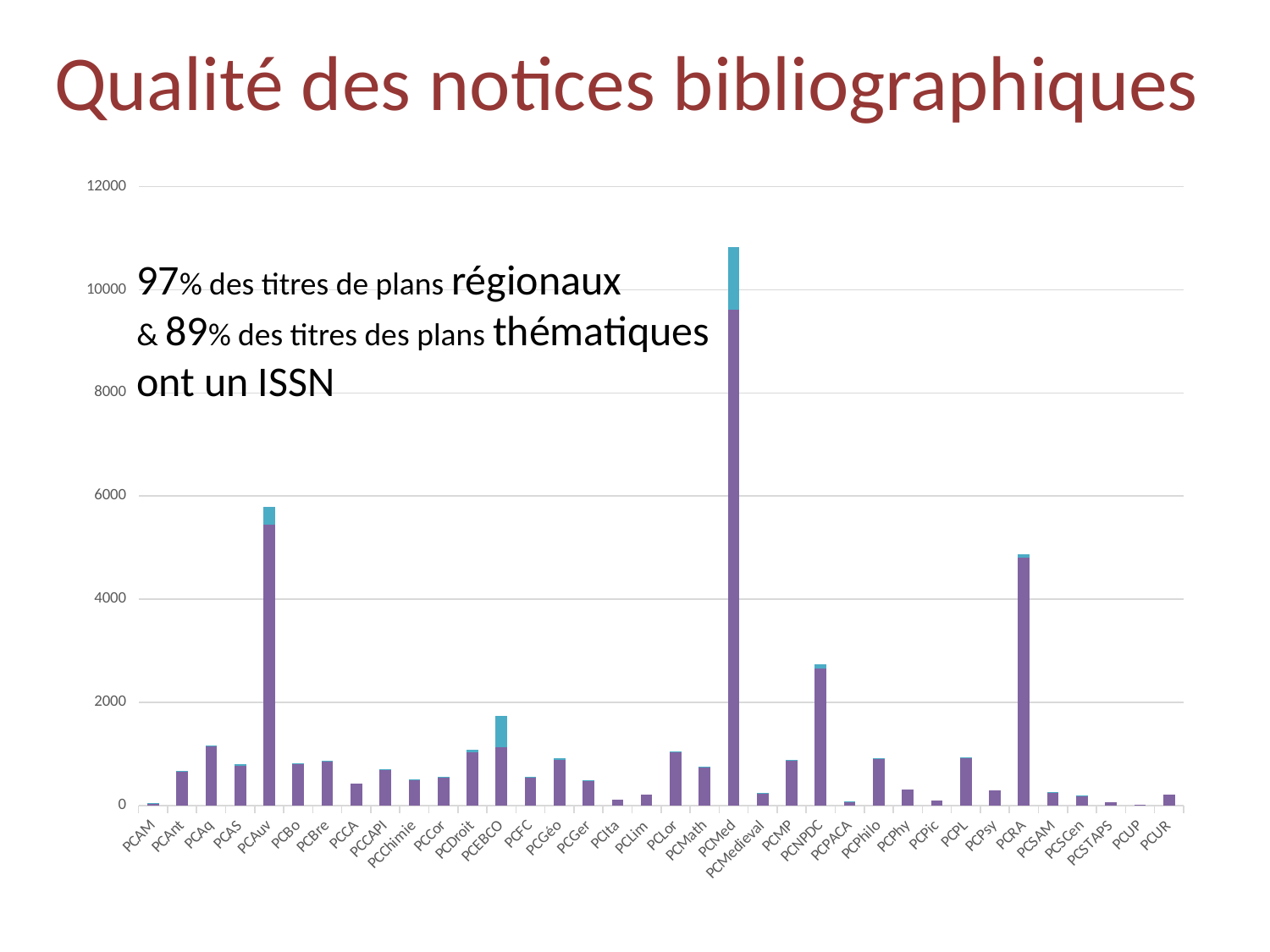
Which is larger, the bar for PCNPDC or the bar for PCRA? PCRA Is the value for PCEBCO greater or less than 2000? less Is the value for PCMed greater or less than 10000? greater What is the title of the slide? Qualité des notices bibliographiques Is the value for PCRA greater or less than 6000? less Which category has the highest bar? PCMed What is the maximum value shown on the vertical axis? 12000 How many categories are shown on the x axis? 36 Which is larger, the bar for PCAuv or the bar for PCRA? PCAuv What kind of chart is shown on the slide? bar chart